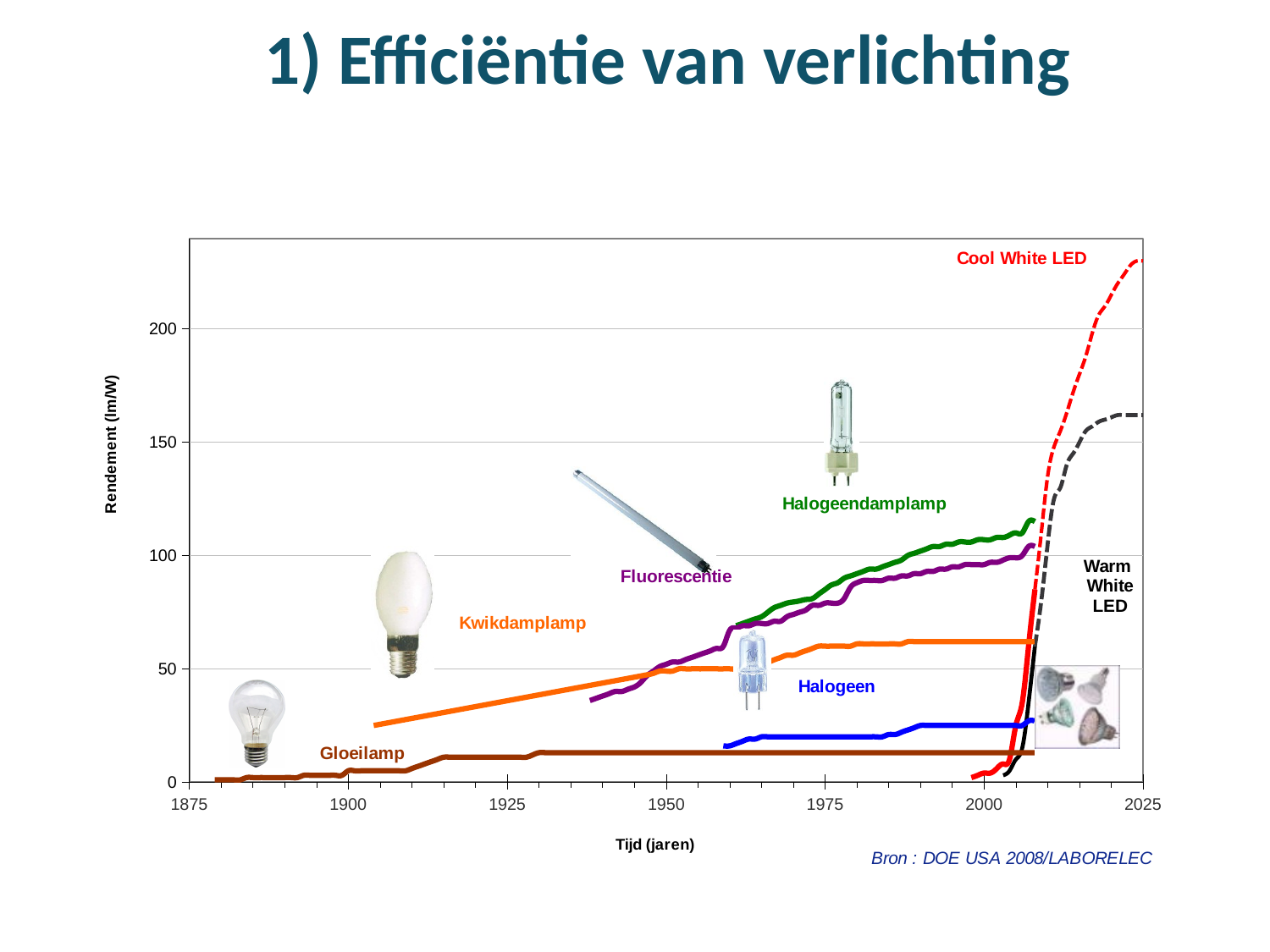
Around 2025, which is higher: Cool White LED or Warm White LED? Cool White LED Which series reaches the highest value at the right end of the chart (around 2025)? Cool White LED Is the value for Halogeen around the year 2000 greater or less than 50? less Is the value for Cool White LED at 2025 greater or less than 200? greater Does the Kwikdamplamp line rise or fall from 1900 to 2000? rise What kind of chart is shown on the slide? line chart Which series has the lowest value around the year 2000? Cool White LED Is the value for Warm White LED at 2025 greater or less than 200? less How many lighting technologies (series) are labelled on the chart? 7 What is the label of the vertical axis? Rendement (lm/W)